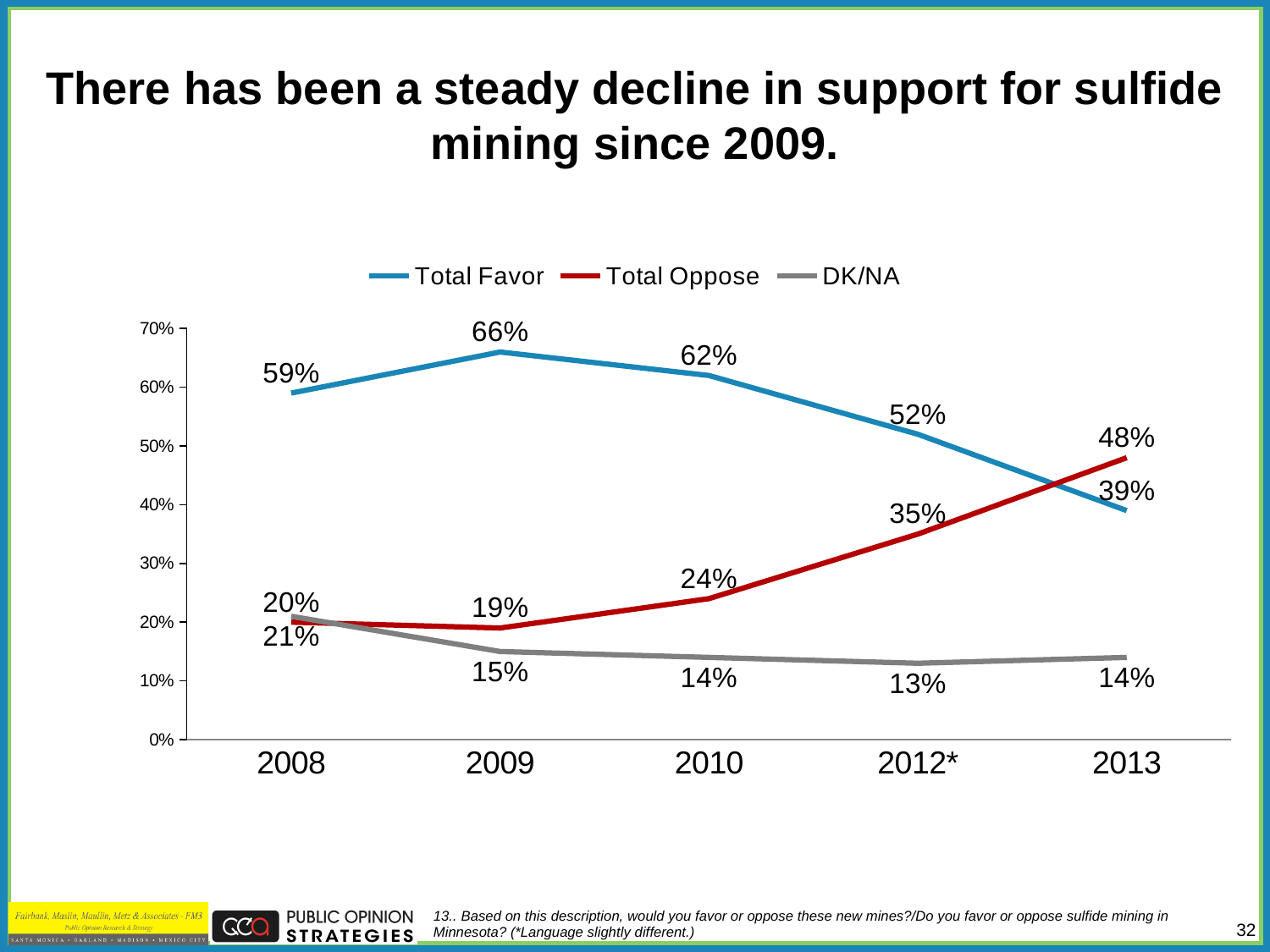
In which year is Total Favor highest? 2009 What is the difference between Total Favor and Total Oppose in 2013? 9% What is the DK/NA value for 2012*? 13% What colour is the Total Oppose line? red Which is larger in 2012*, Total Favor or Total Oppose? Total Favor What kind of chart is shown on the slide? line chart What is the Total Favor value for 2009? 66% How does Total Favor change from 2009 to 2013? falls How many years are shown on the x axis? 5 In which year is Total Oppose lowest? 2009 How many series does the legend list? 3 What is the Total Oppose value for 2013? 48%